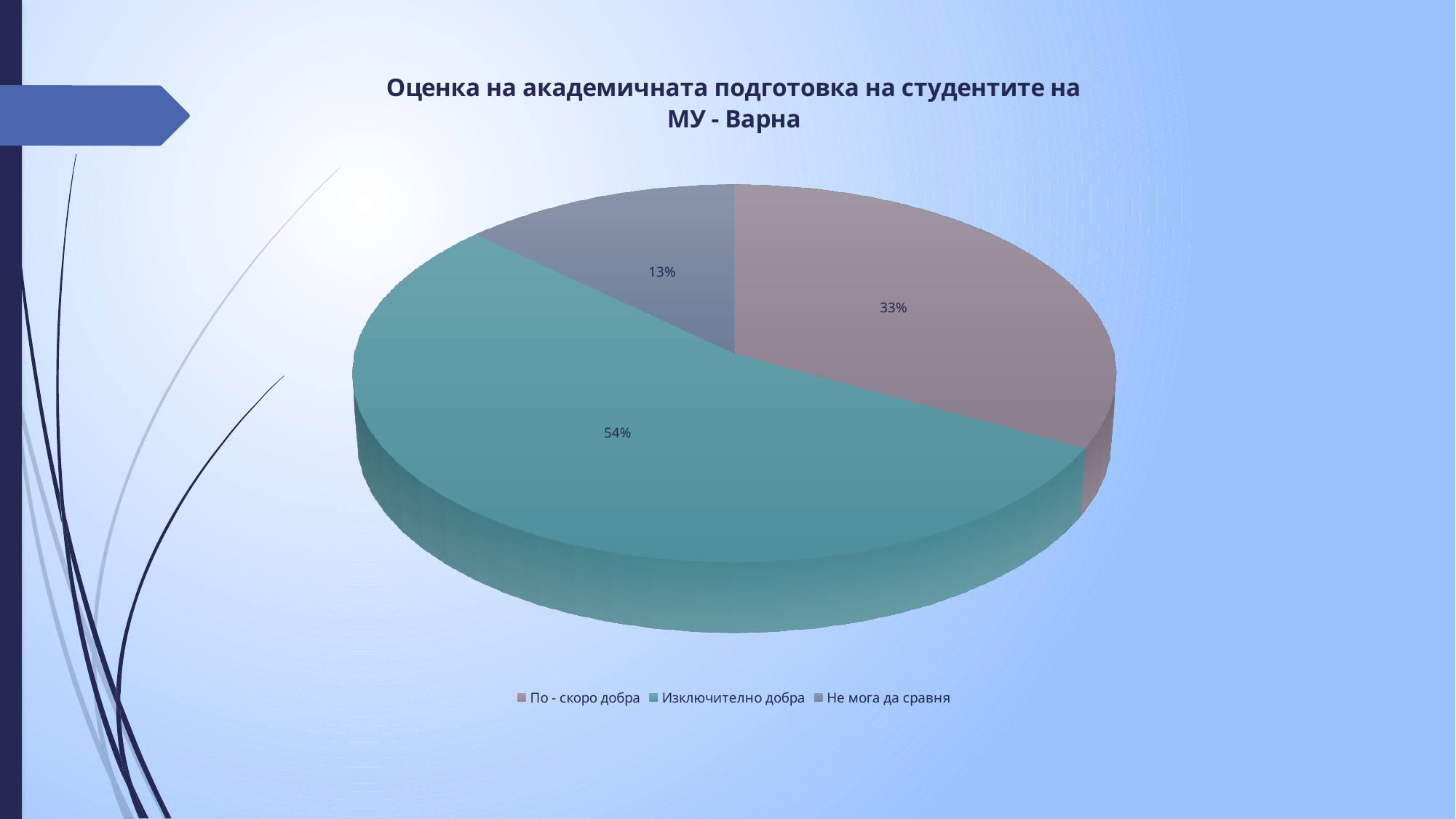
What share of the pie is 'Не мога да сравня'? 13% What kind of chart is shown on the slide? Pie chart Which category has the largest share of the pie? Изключително добра Which category has the smallest share of the pie? Не мога да сравня What share of the pie is 'По - скоро добра'? 33% What is the difference between the shares of 'Изключително добра' and 'По - скоро добра'? 21% What share of the pie is 'Изключително добра'? 54% Which is larger, the share for 'По - скоро добра' or the share for 'Не мога да сравня'? По - скоро добра What is the title of the chart? Оценка на академичната подготовка на студентите на МУ - Варна How many entries does the legend list? 3 How many slices does the pie chart have? 3 What colour is the slice for 'Изключително добра'? Teal (green)